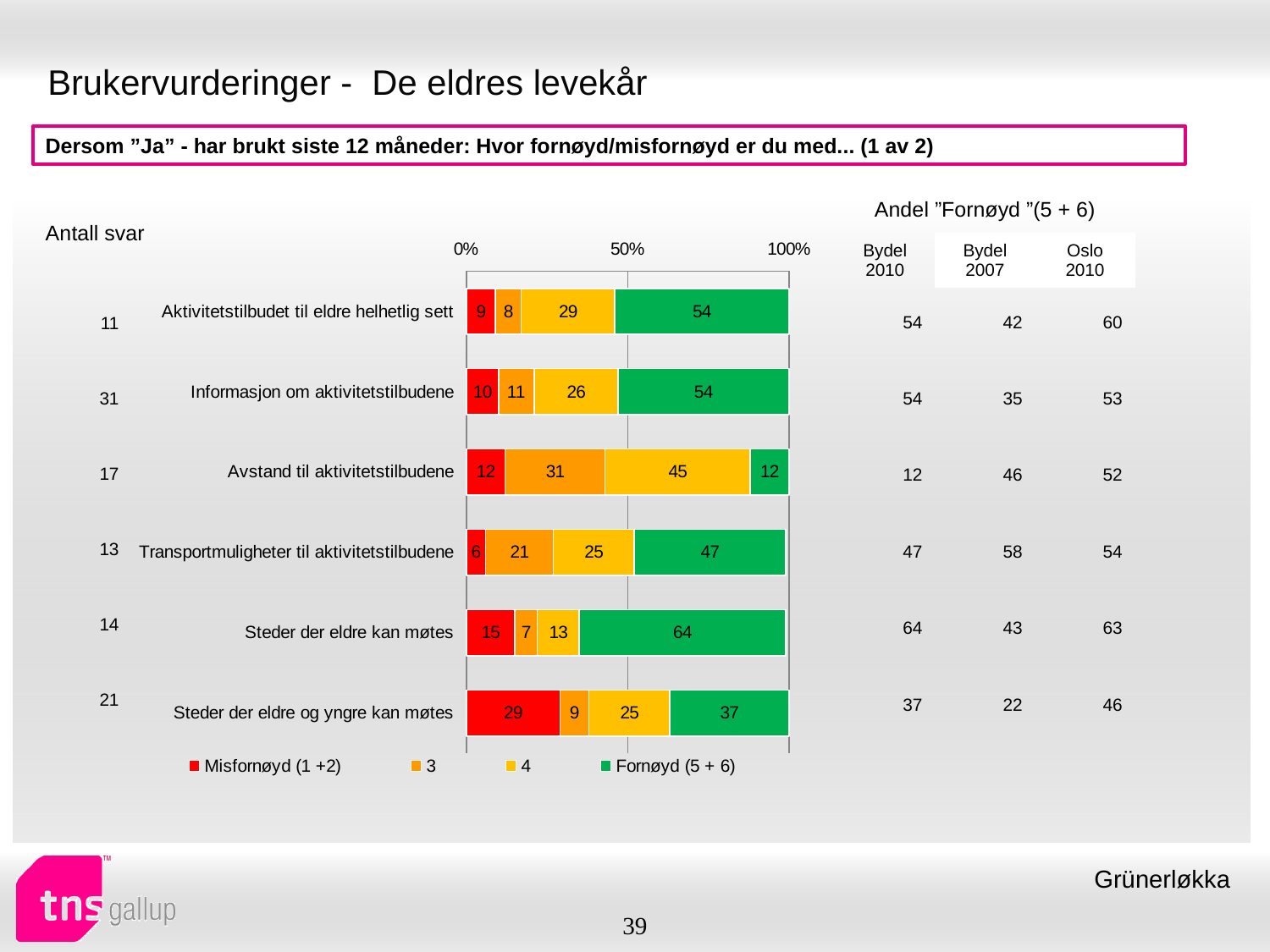
What is the difference between the Fornøyd (5 + 6) values for Steder der eldre kan møtes and Steder der eldre og yngre kan møtes? 27 What is the total of the stacked bar for Aktivitetstilbudet til eldre helhetlig sett? 100 What is the value of series 4 for Avstand til aktivitetstilbudene? 45 Which category has the lowest Fornøyd (5 + 6) value? Avstand til aktivitetstilbudene What is the Fornøyd (5 + 6) value for Steder der eldre kan møtes? 64 What kind of chart is shown on the slide? stacked bar chart Which category has the highest Fornøyd (5 + 6) value? Steder der eldre kan møtes What is the Misfornøyd (1 +2) value for Steder der eldre og yngre kan møtes? 29 What is the value of series 3 for Transportmuligheter til aktivitetstilbudene? 21 Which is larger: the Misfornøyd (1 +2) value for Steder der eldre kan møtes or for Transportmuligheter til aktivitetstilbudene? Steder der eldre kan møtes How many categories are plotted in the bar chart? 6 How many series does the chart legend list? 4